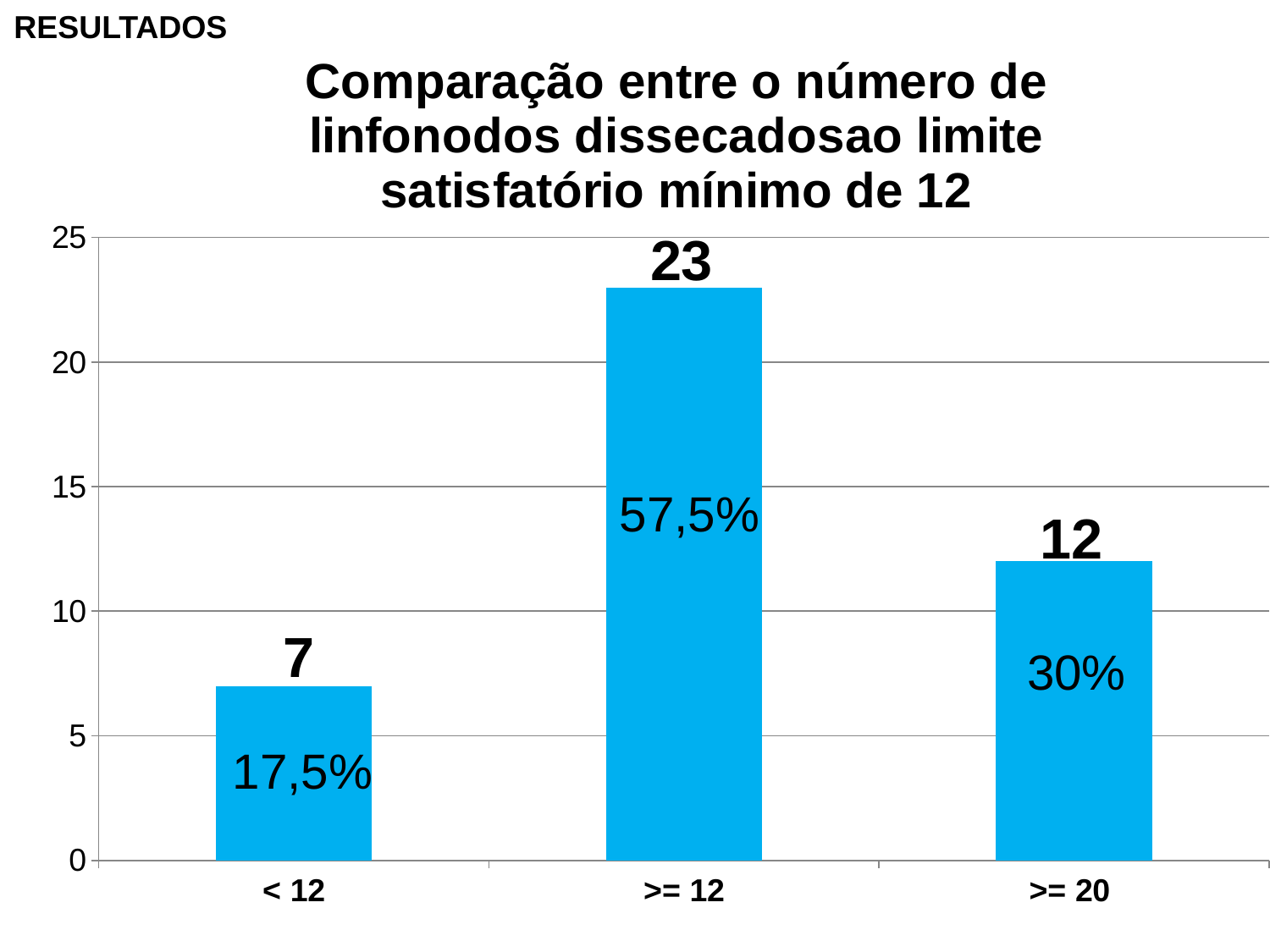
Which category has the highest value? >= 12 Which category has the lowest value? < 12 What is the value for the ">= 20" category? 12 What is the value for the ">= 12" category? 23 What kind of chart is shown on the slide? Bar chart Which is larger, the value for ">= 20" or the value for "< 12"? >= 20 Is the value for ">= 12" greater or less than 20? greater What percentage is shown inside the "< 12" bar? 17,5% How many categories are shown on the x axis? 3 What is the difference between the values for ">= 12" and ">= 20"? 11 What is the value for the "< 12" category? 7 What percentage is shown inside the ">= 12" bar? 57,5%